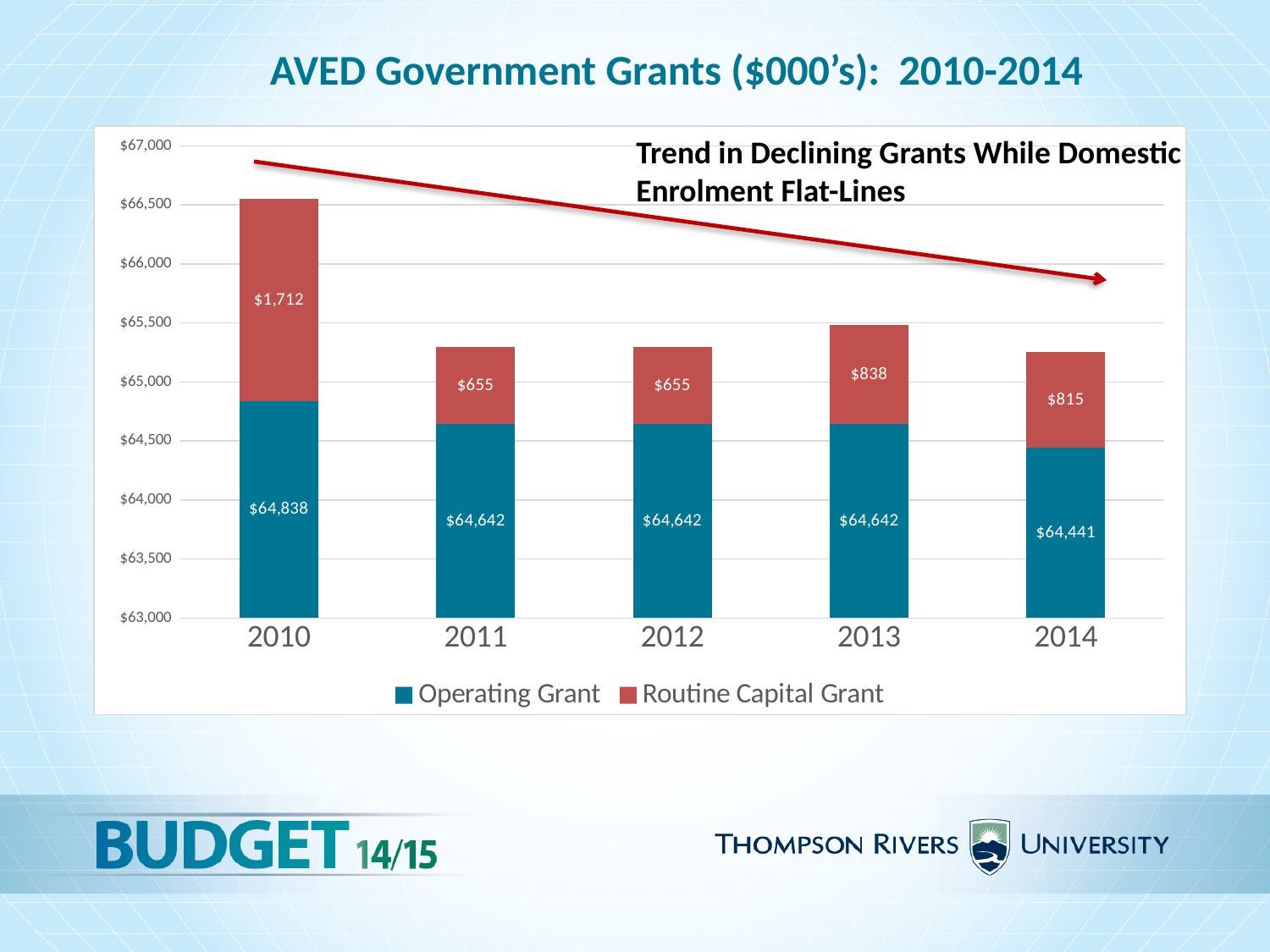
What is the Routine Capital Grant value for 2013? $838 How many years are shown on the x axis? 5 What type of chart is shown on the slide? Stacked bar chart What is the difference between the Routine Capital Grant in 2010 and in 2011? $1,057 Which year has the lowest Operating Grant? 2014 What is the total of the stacked bar for 2010? $66,550 What is the Operating Grant value for 2010? $64,838 What is the Operating Grant value for 2014? $64,441 What is the total of the stacked bar for 2014? $65,256 Which year has the highest Routine Capital Grant? 2010 Is the Routine Capital Grant larger in 2013 or in 2014? 2013 How many series does the legend list? 2